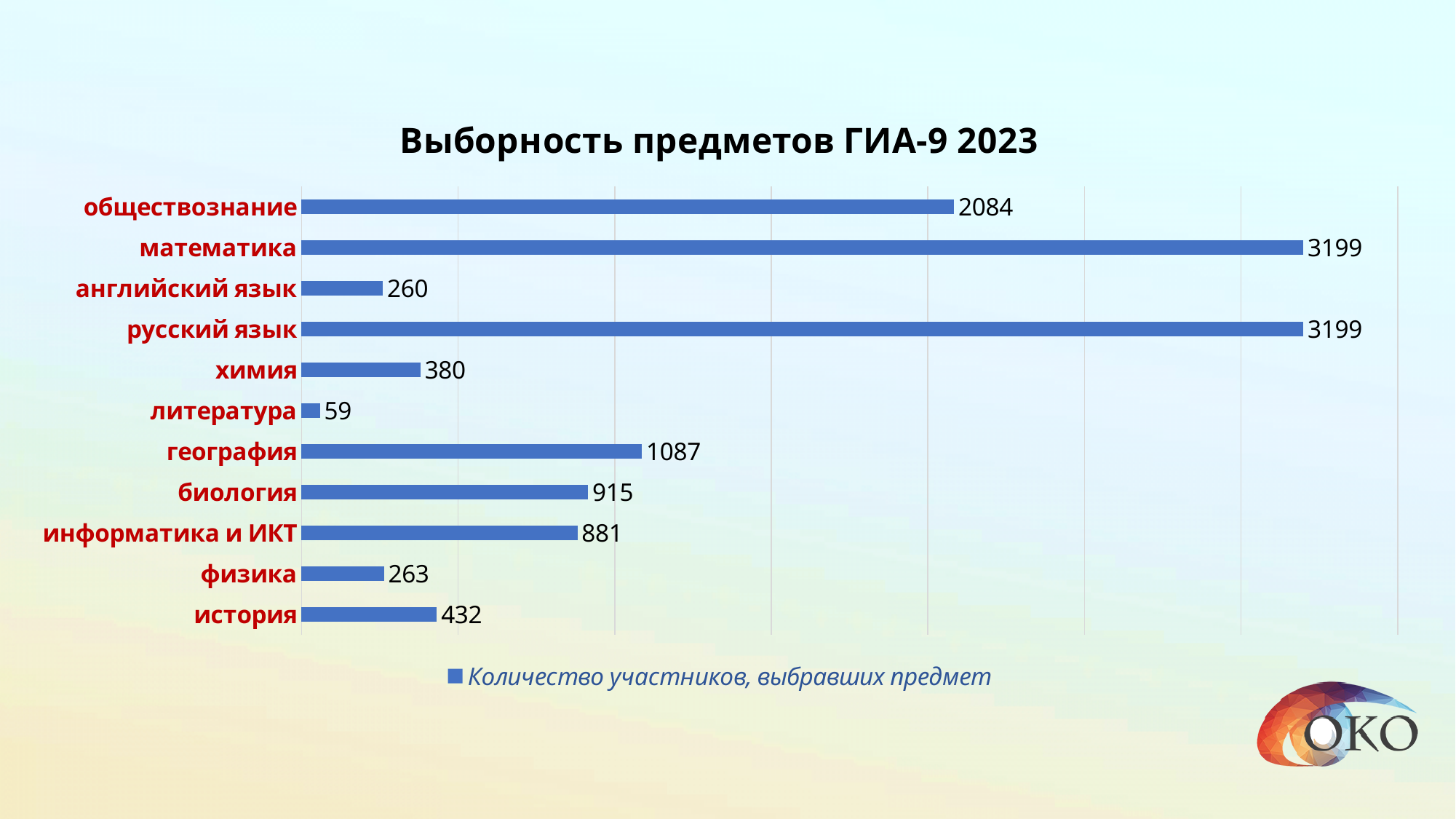
What is the difference between the values for обществознание and география? 997 How many subjects (categories) are shown in the chart? 11 How many series does the legend list? 1 What is the value for литература? 59 What is the value for обществознание? 2084 Which subject has the lowest value? литература What is the difference between the values for история and химия? 52 What kind of chart is shown on the slide? bar chart Which is larger, the value for биология or the value for информатика и ИКТ? биология What is the value for информатика и ИКТ? 881 What is the value for география? 1087 What is the title of the chart? Выборность предметов ГИА-9 2023